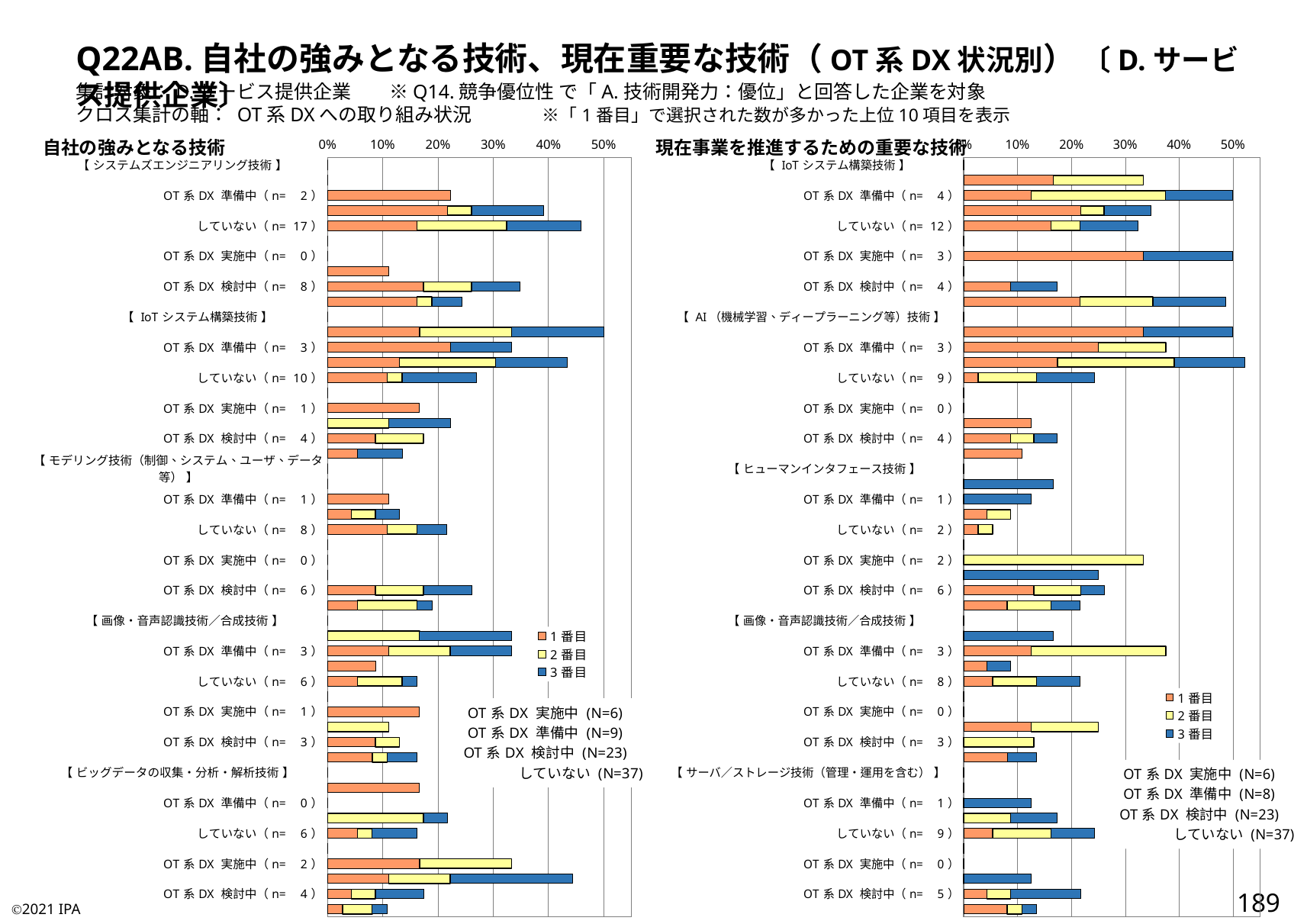
What kind of chart is the left chart titled 自社の強みとなる技術? bar chart In the left chart 自社の強みとなる技術, is the total stacked value for the bar in the row labelled OT系DX 準備中（n= 3） under 【IoTシステム構築技術】 greater or less than 30%? greater What kind of chart is the right chart titled 現在事業を推進するための重要な技術? bar chart In the right chart 現在事業を推進するための重要な技術, how many series does the legend list? 3 In the left chart 自社の強みとなる技術, how many series does the legend list? 3 In the left chart 自社の強みとなる技術, what are the legend entries? 1番目, 2番目, 3番目 In the left chart 自社の強みとなる技術, is the total stacked value for the bar in the row labelled していない（n= 17） greater or less than 40%? greater What is the title of the chart on the right side of the slide? 現在事業を推進するための重要な技術 In the right chart 現在事業を推進するための重要な技術, is the total stacked value for the bar in the row labelled OT系DX 検討中（n= 4） under 【IoTシステム構築技術】 greater or less than 20%? less